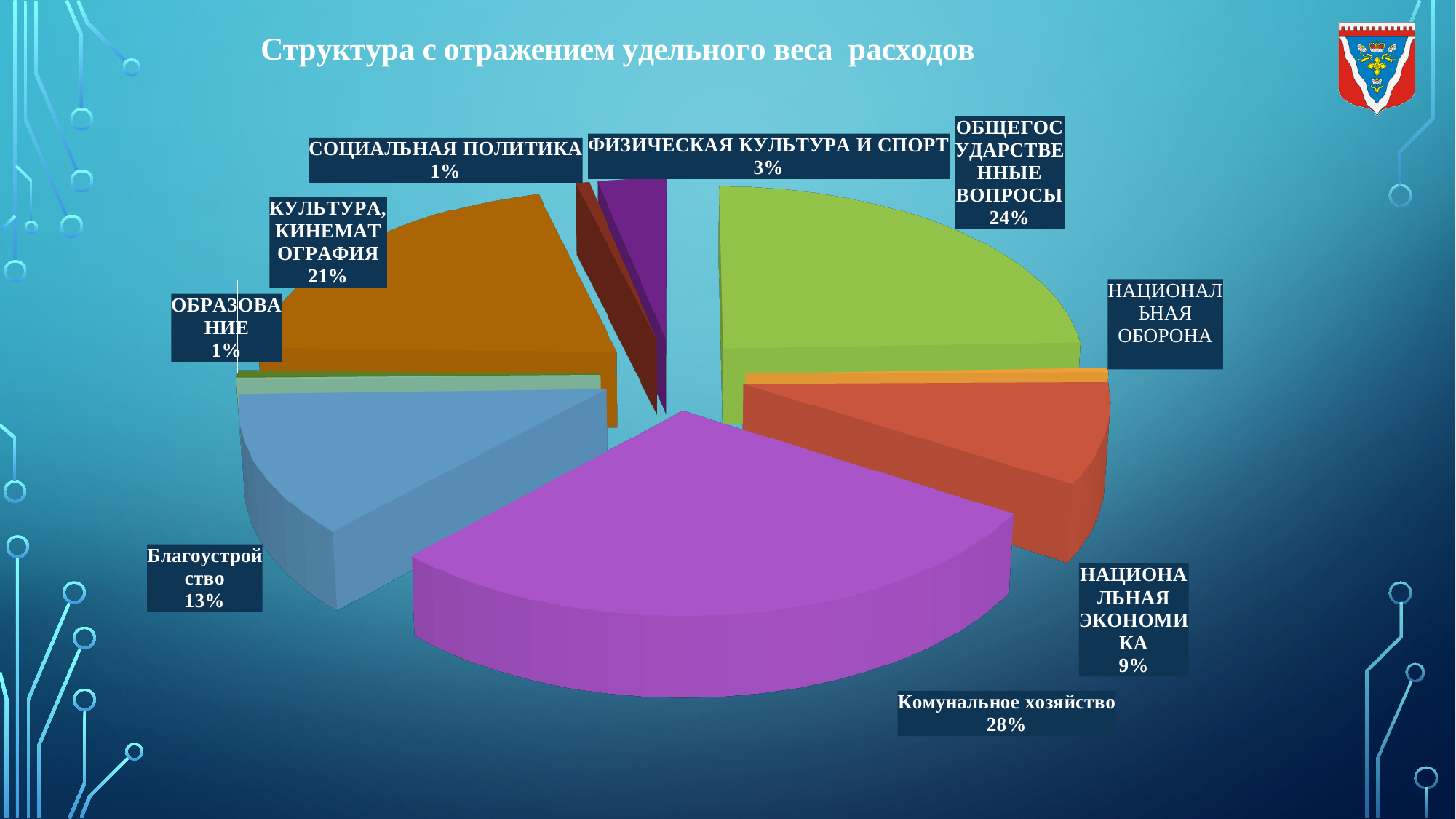
How many categories are labelled on the pie chart? 9 What percentage is shown for Физическая культура и спорт? 3% What is the title of the chart? Структура с отражением удельного веса расходов Which category has the largest share of the pie? Комунальное хозяйство What percentage is shown for Общегосударственные вопросы? 24% What percentage is shown for Национальная экономика? 9% What share of expenditures does Комунальное хозяйство account for? 28% What percentage is shown for Культура, кинематография? 21% What kind of chart is shown on the slide? Pie chart What share is labelled for Благоустройство? 13% Which is larger: Культура, кинематография or Благоустройство? Культура, кинематография How many percentage points larger is Комунальное хозяйство than Общегосударственные вопросы? 4%